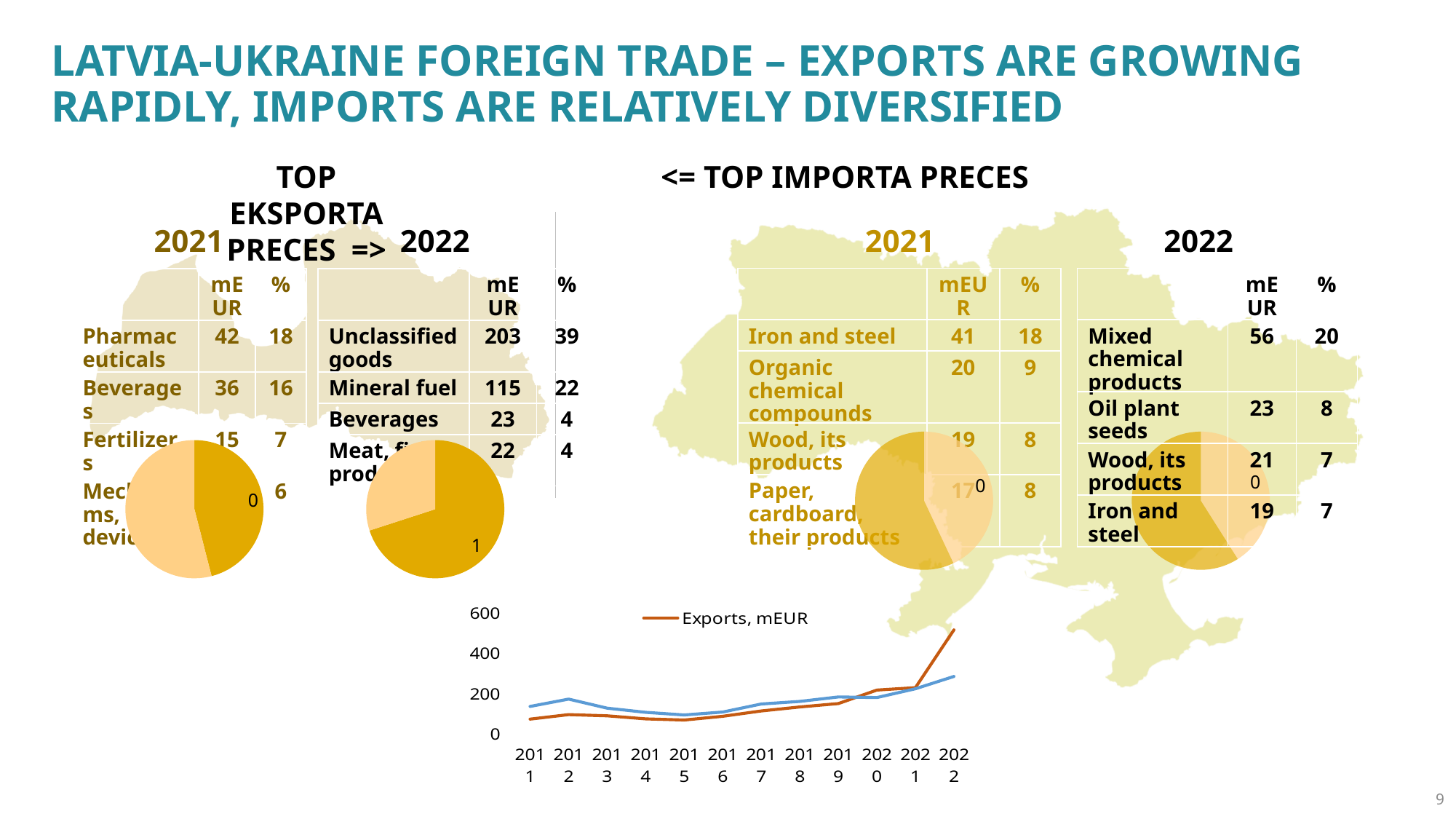
In the bottom line chart, is the value for Exports, mEUR in 2022 greater or less than 400? greater In the bottom line chart, what is the highest value shown on the y axis? 600 What kind of chart is the chart at the bottom of the slide with the 'Exports, mEUR' legend? line chart In the bottom line chart, is the value for Exports, mEUR in 2015 greater or less than 200? less In the bottom line chart, do exports rise or fall overall from 2011 to 2022? rise In the bottom line chart, what is the last year on the x axis? 2022 In the bottom line chart, which year has the highest value for Exports, mEUR? 2022 How many pie charts are shown on the slide? 4 In the bottom line chart, what is the first year on the x axis? 2011 In the bottom line chart, which year has the larger value for Exports, mEUR: 2011 or 2022? 2022 In the bottom line chart, is the value for Exports, mEUR in 2011 greater or less than 200? less In the bottom line chart, how many years are shown on the x axis? 12